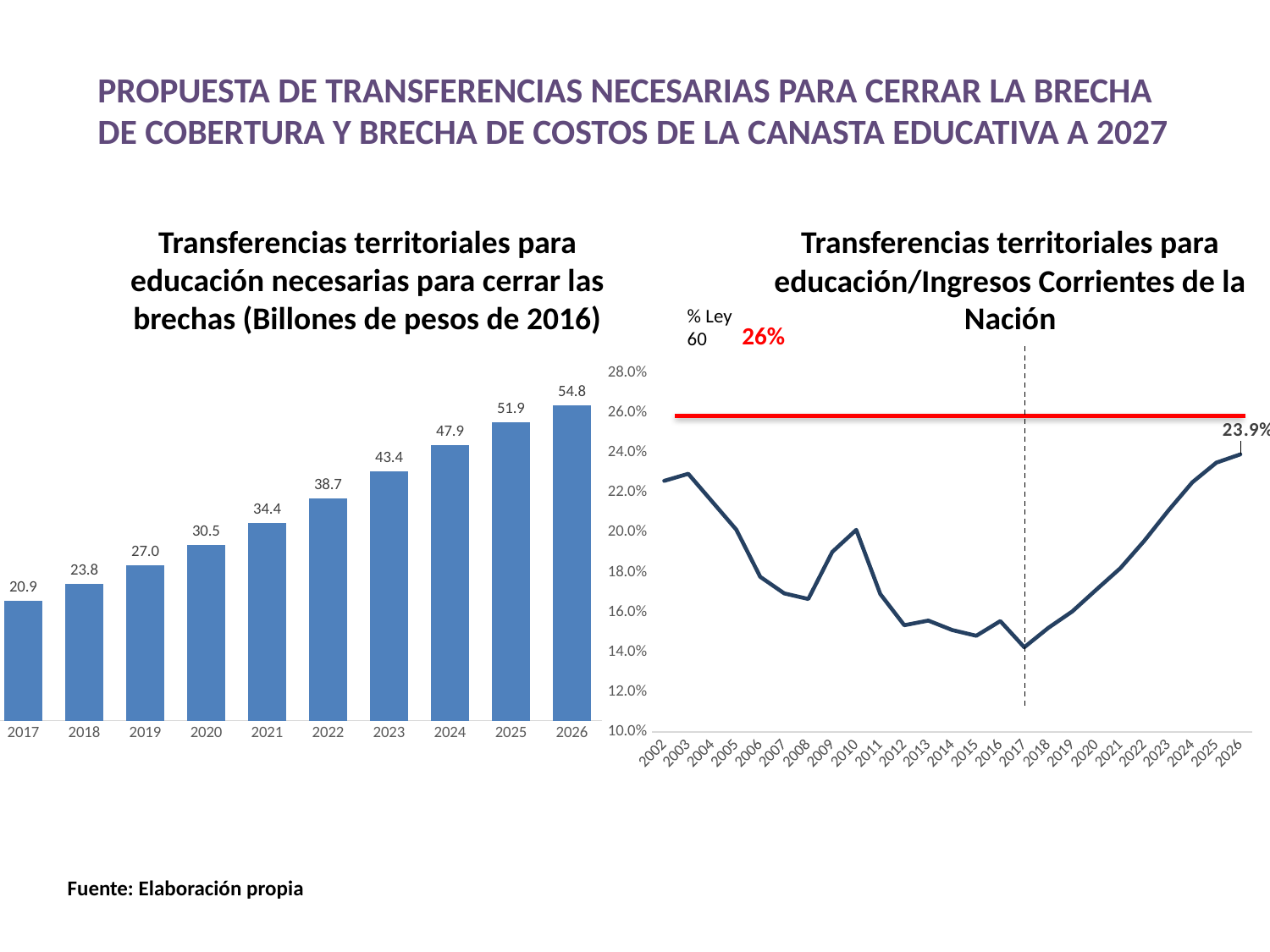
In the left chart (Transferencias territoriales para educación necesarias para cerrar las brechas), what is the value for 2022? 38.7 In the left chart (Transferencias territoriales para educación necesarias para cerrar las brechas), what is the value for 2017? 20.9 In the right chart (Transferencias territoriales para educación/Ingresos Corrientes de la Nación), is the value for 2010 greater or less than 18.0%? greater In the right chart (Transferencias territoriales para educación/Ingresos Corrientes de la Nación), what percentage does the red horizontal line (% Ley 60) mark? 26% In the left chart (Transferencias territoriales para educación necesarias para cerrar las brechas), what is the difference between the values for 2026 and 2017? 33.9 In the left chart (Transferencias territoriales para educación necesarias para cerrar las brechas), which year has the lowest value? 2017 In the left chart (Transferencias territoriales para educación necesarias para cerrar las brechas), which year has the highest value? 2026 In the right chart (Transferencias territoriales para educación/Ingresos Corrientes de la Nación), what is the value labelled for 2026? 23.9% In the left chart (Transferencias territoriales para educación necesarias para cerrar las brechas), how many years are shown? 10 In the left chart (Transferencias territoriales para educación necesarias para cerrar las brechas), do the values rise or fall from 2017 to 2026? rise In the right chart (Transferencias territoriales para educación/Ingresos Corrientes de la Nación), is the value for 2017 greater or less than 16.0%? less What kind of chart is the left chart (Transferencias territoriales para educación necesarias para cerrar las brechas)? bar chart